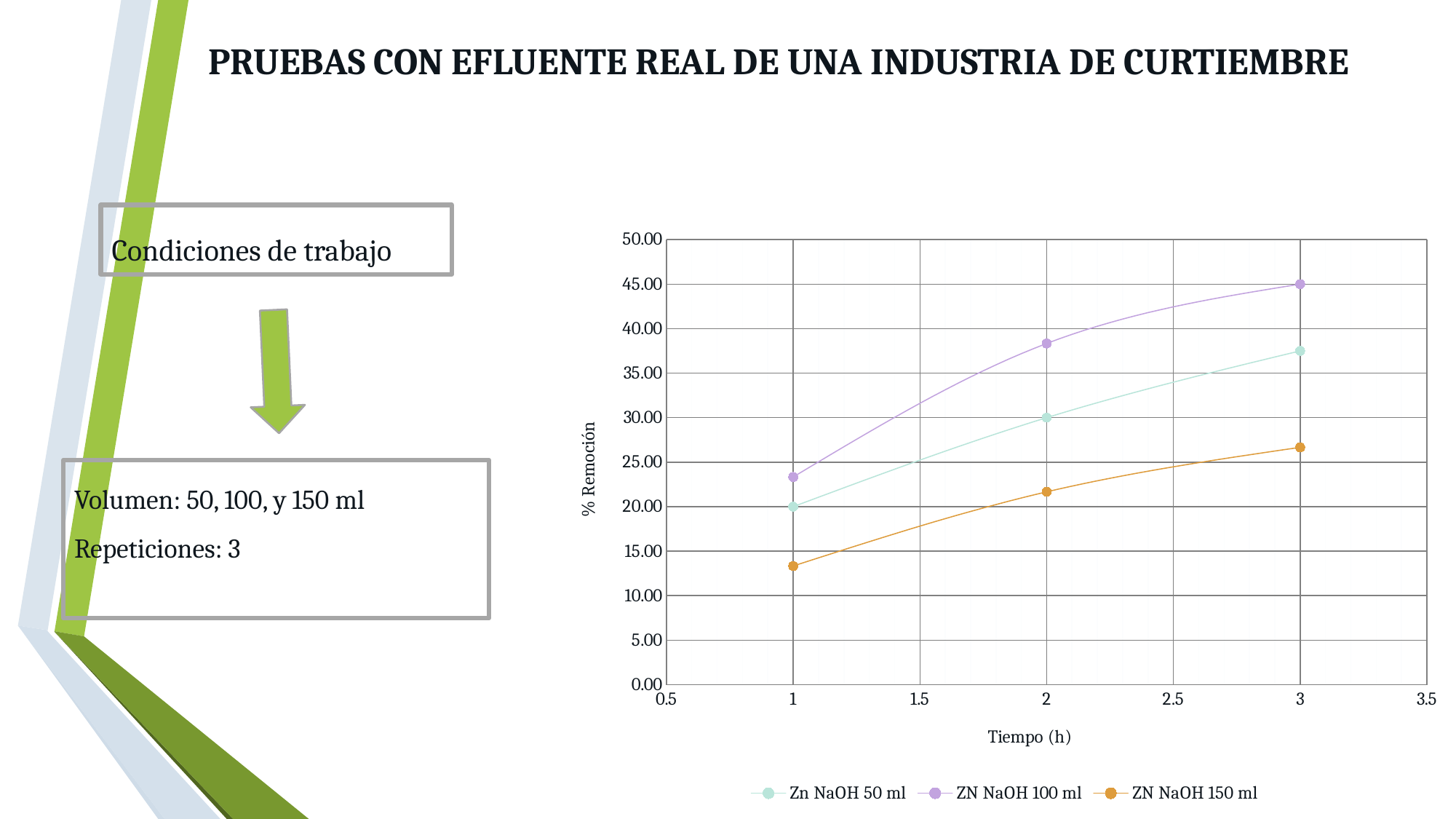
Which series has the highest % Remoción at 3 h? ZN NaOH 100 ml Does the % Remoción for ZN NaOH 100 ml rise or fall as Tiempo (h) increases? rise Is the % Remoción for ZN NaOH 150 ml at 3 h greater or less than 25.00? greater Is the % Remoción for Zn NaOH 50 ml at 3 h greater or less than 40.00? less Which series has the lowest % Remoción at 1 h? ZN NaOH 150 ml What is the label of the y axis? % Remoción How many time points are plotted for each series? 3 What kind of chart is shown on the slide? line chart Is the % Remoción for ZN NaOH 150 ml at 1 h greater or less than 15.00? less At 2 h, which is larger: the % Remoción for Zn NaOH 50 ml or for ZN NaOH 150 ml? Zn NaOH 50 ml How many series does the legend list? 3